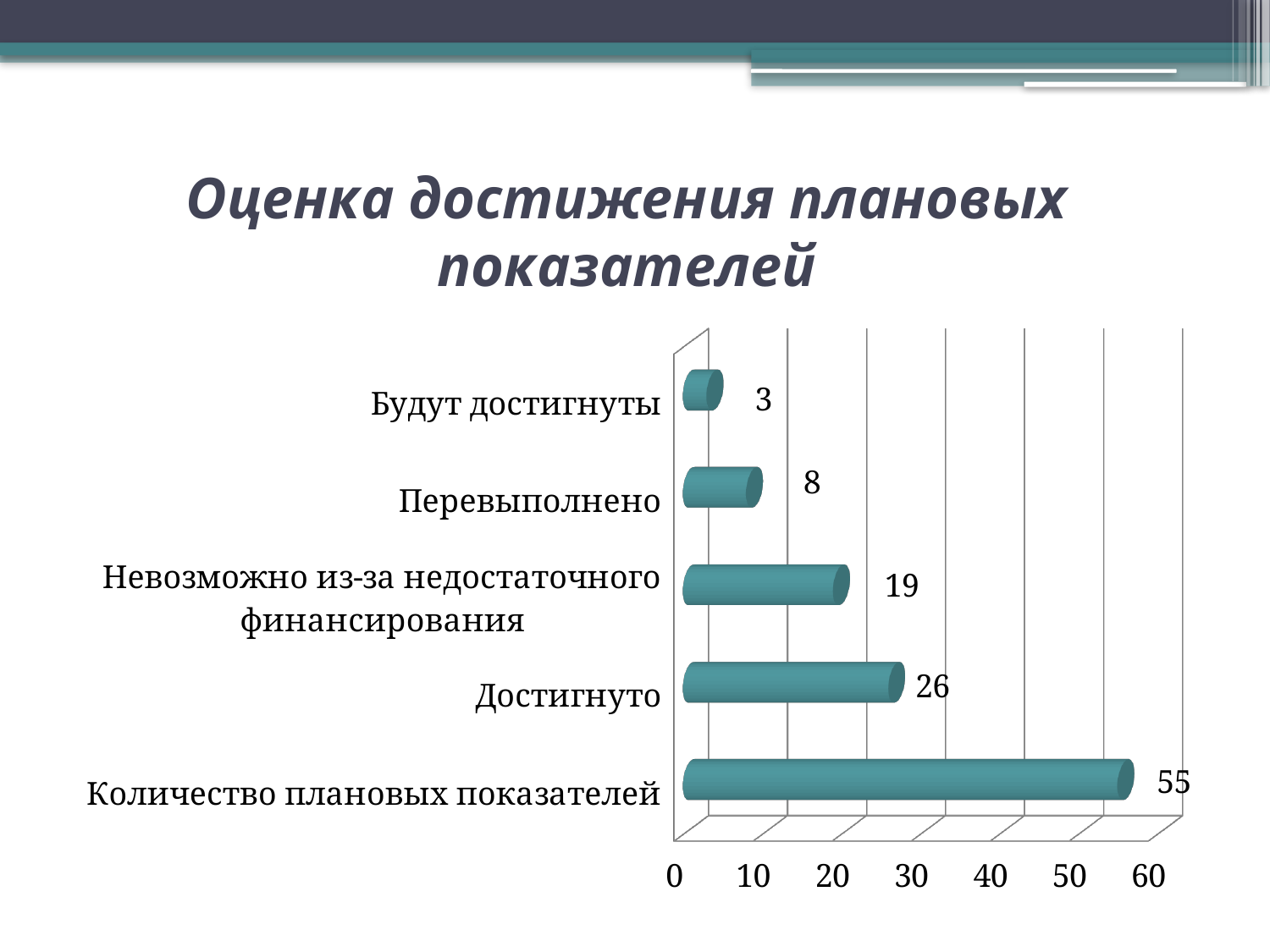
Which category has the highest value? Количество плановых показателей What is the value for «Количество плановых показателей»? 55 What is the value for «Невозможно из-за недостаточного финансирования»? 19 How many categories are shown in the chart? 5 What is the title of the slide? Оценка достижения плановых показателей What is the value for «Достигнуто»? 26 What is the value for «Перевыполнено»? 8 What is the value for «Будут достигнуты»? 3 Which is larger: the value for «Перевыполнено» or the value for «Будут достигнуты»? Перевыполнено What is the difference between the values for «Достигнуто» and «Невозможно из-за недостаточного финансирования»? 7 What kind of chart is shown on the slide? Bar chart Which category has the lowest value? Будут достигнуты